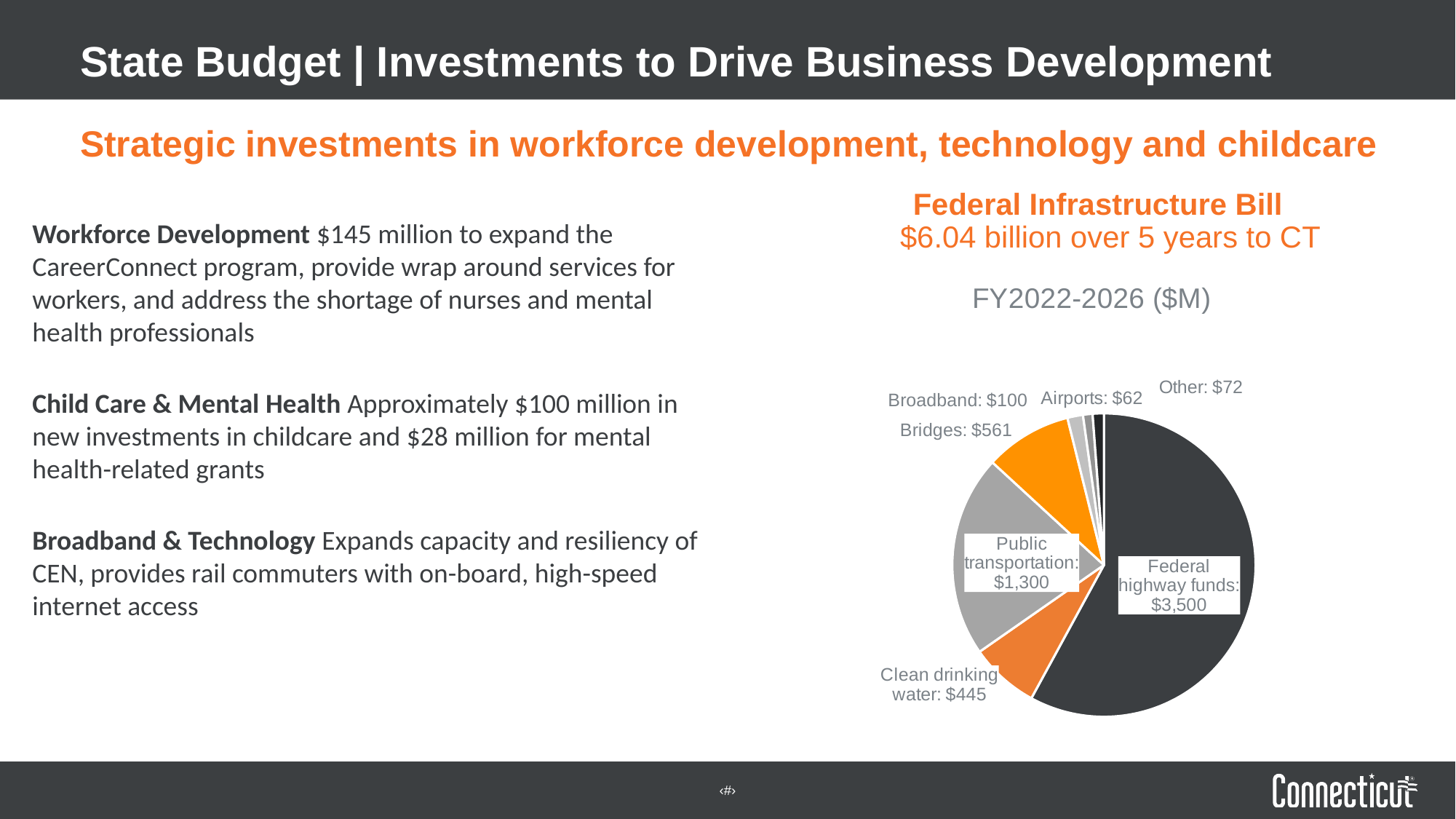
What kind of chart is shown on the slide? Pie chart What is the value for Bridges in the pie chart? $561 Which is larger in the pie chart, Bridges or Clean drinking water? Bridges What is the total of all slices in the pie chart? $6,040 How many slices does the pie chart have? 7 Which category has the largest slice in the pie chart? Federal highway funds What is the value for Federal highway funds in the pie chart? $3,500 What is the value for Clean drinking water in the pie chart? $445 What is the title of the pie chart? FY2022-2026 ($M) Which category has the smallest slice in the pie chart? Airports What is the difference between Federal highway funds and Public transportation in the pie chart? $2,200 What is the value for Public transportation in the pie chart? $1,300